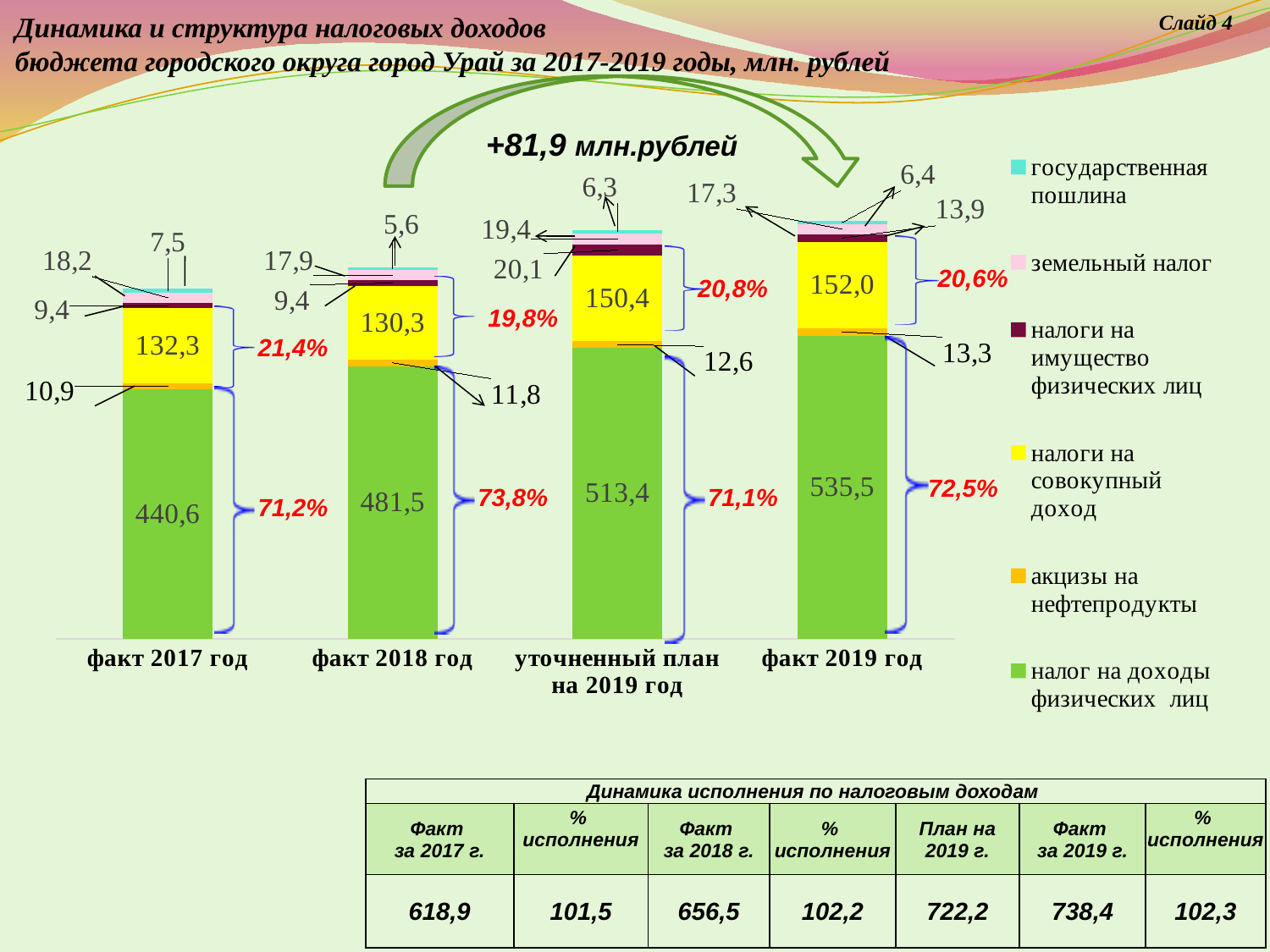
How many series does the chart legend list? 6 How many bars (categories) are shown on the x axis of the chart? 4 What is the difference in налог на доходы физических лиц between факт 2019 год and факт 2018 год? 54,0 Does the value of налог на доходы физических лиц rise or fall from факт 2017 год to факт 2019 год? rise Which category has the lowest value for налог на доходы физических лиц? факт 2017 год Which category has the highest value for налог на доходы физических лиц? факт 2019 год What is the value of государственная пошлина for факт 2018 год? 5,6 What type of chart is shown on the slide? stacked bar chart What is the value of налоги на совокупный доход for факт 2017 год? 132,3 What is the value of акцизы на нефтепродукты for уточненный план на 2019 год? 12,6 Which is larger: налоги на совокупный доход for факт 2017 год or for факт 2018 год? факт 2017 год What is the value of налог на доходы физических лиц for факт 2019 год? 535,5